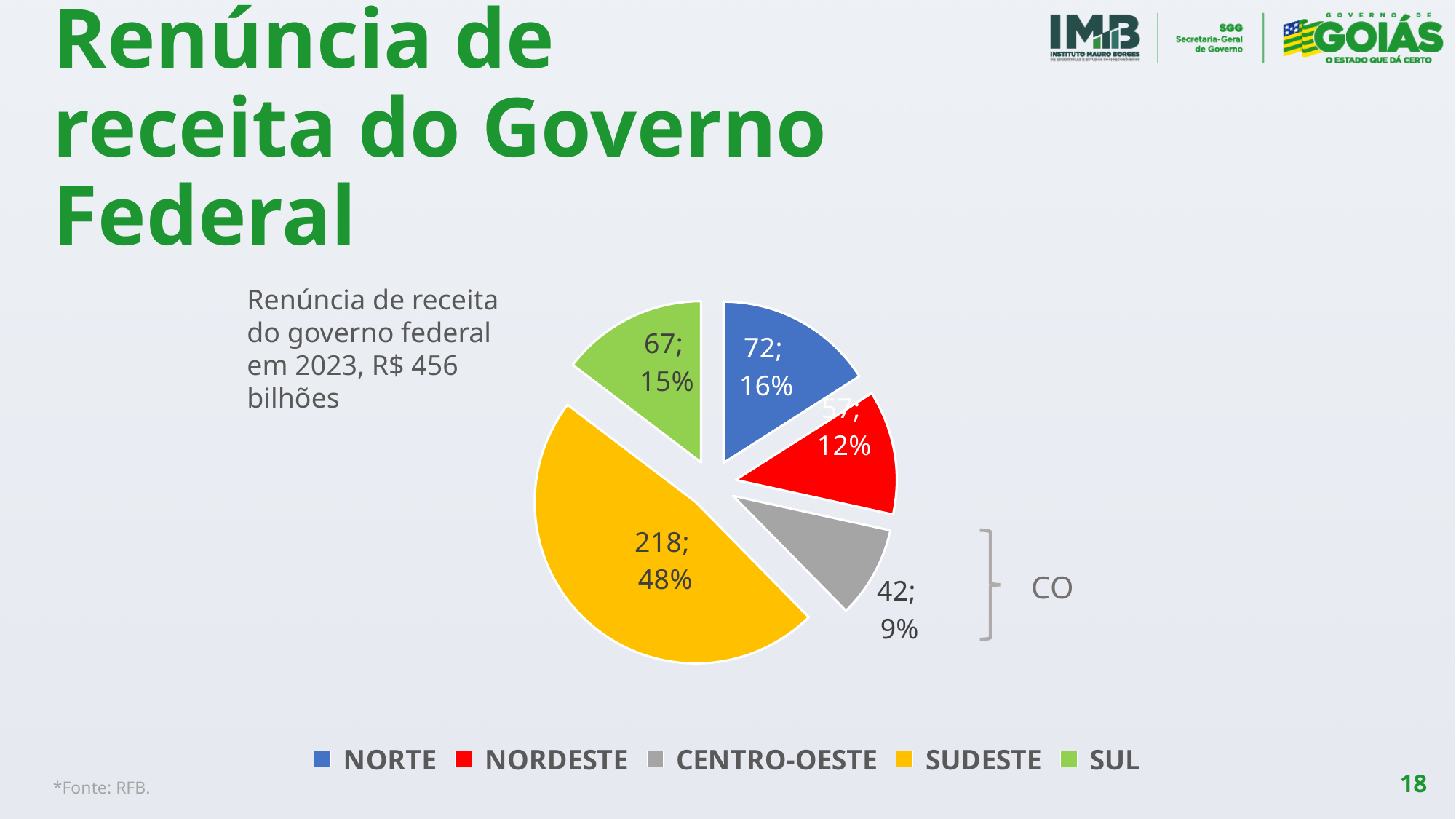
What is the difference between the values for SUDESTE and NORTE? 146 What colour is the SUDESTE slice in the pie chart? Yellow What percentage share does SUL have in the pie chart? 15% How many entries does the legend list? 5 What type of chart is shown on the slide? Pie chart What percentage share does NORTE have in the pie chart? 16% What is the value for CENTRO-OESTE in the pie chart? 42 What is the value for SUDESTE in the pie chart? 218 How many slices does the pie chart have? 5 Which is larger, the value for NORDESTE or the value for SUL? SUL Which region has the largest slice in the pie chart? SUDESTE Which region has the smallest slice in the pie chart? CENTRO-OESTE